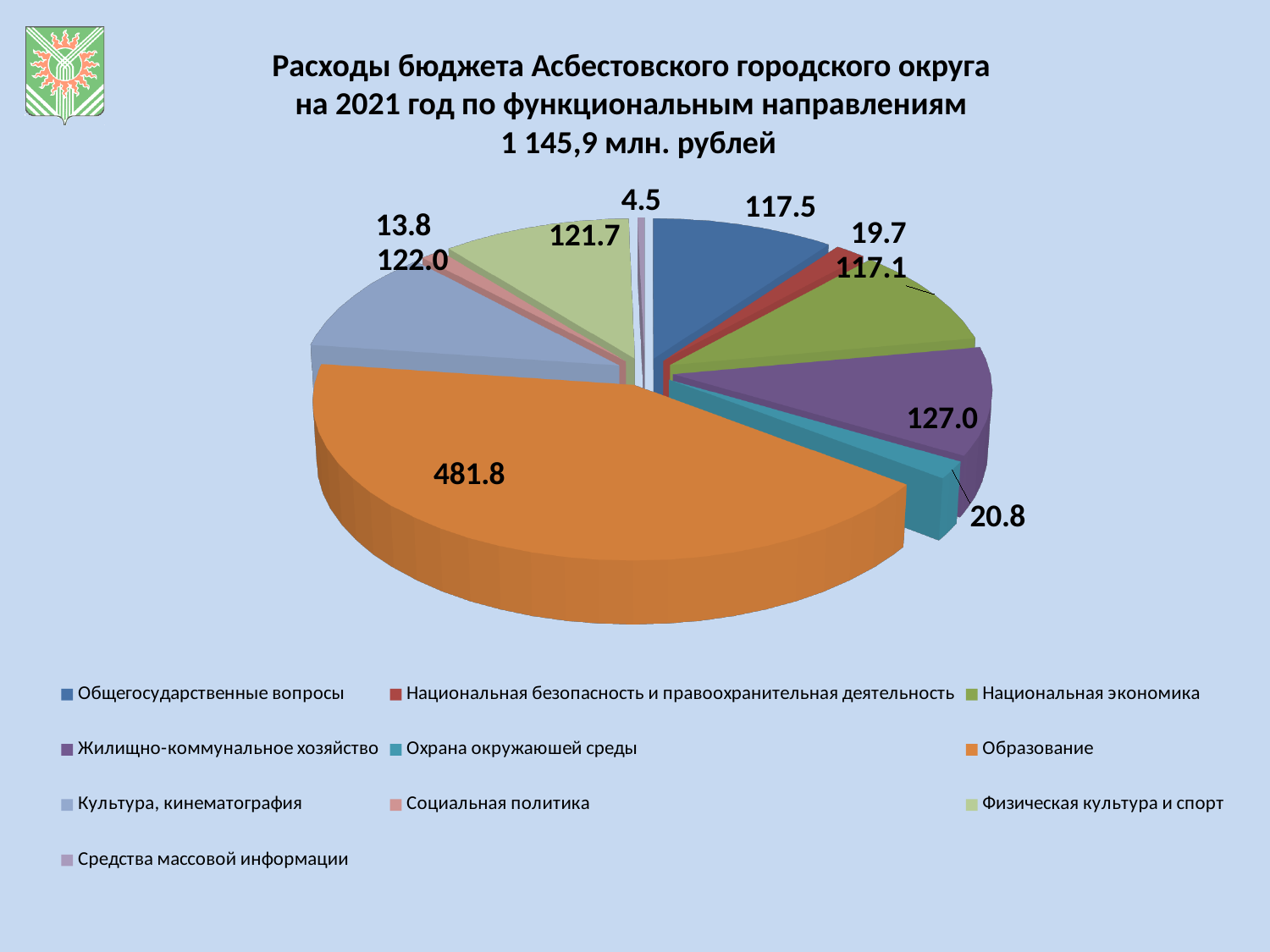
What is the value for Социальная политика? 13.8 What is the value for Образование? 481.8 How many categories does the legend list? 10 What colour is the slice for Образование? orange What type of chart is shown on the slide? pie chart What is the value for Жилищно-коммунальное хозяйство? 127.0 Which category has the smallest slice? Средства массовой информации What is the value for Средства массовой информации? 4.5 Which category has the largest slice? Образование What total amount in million rubles is stated in the chart title? 1 145,9 млн. рублей What is the difference between the values for Образование and Жилищно-коммунальное хозяйство? 354.8 Which is larger, the value for Охрана окружаюшей среды or the value for Национальная безопасность и правоохранительная деятельность? Охрана окружаюшей среды